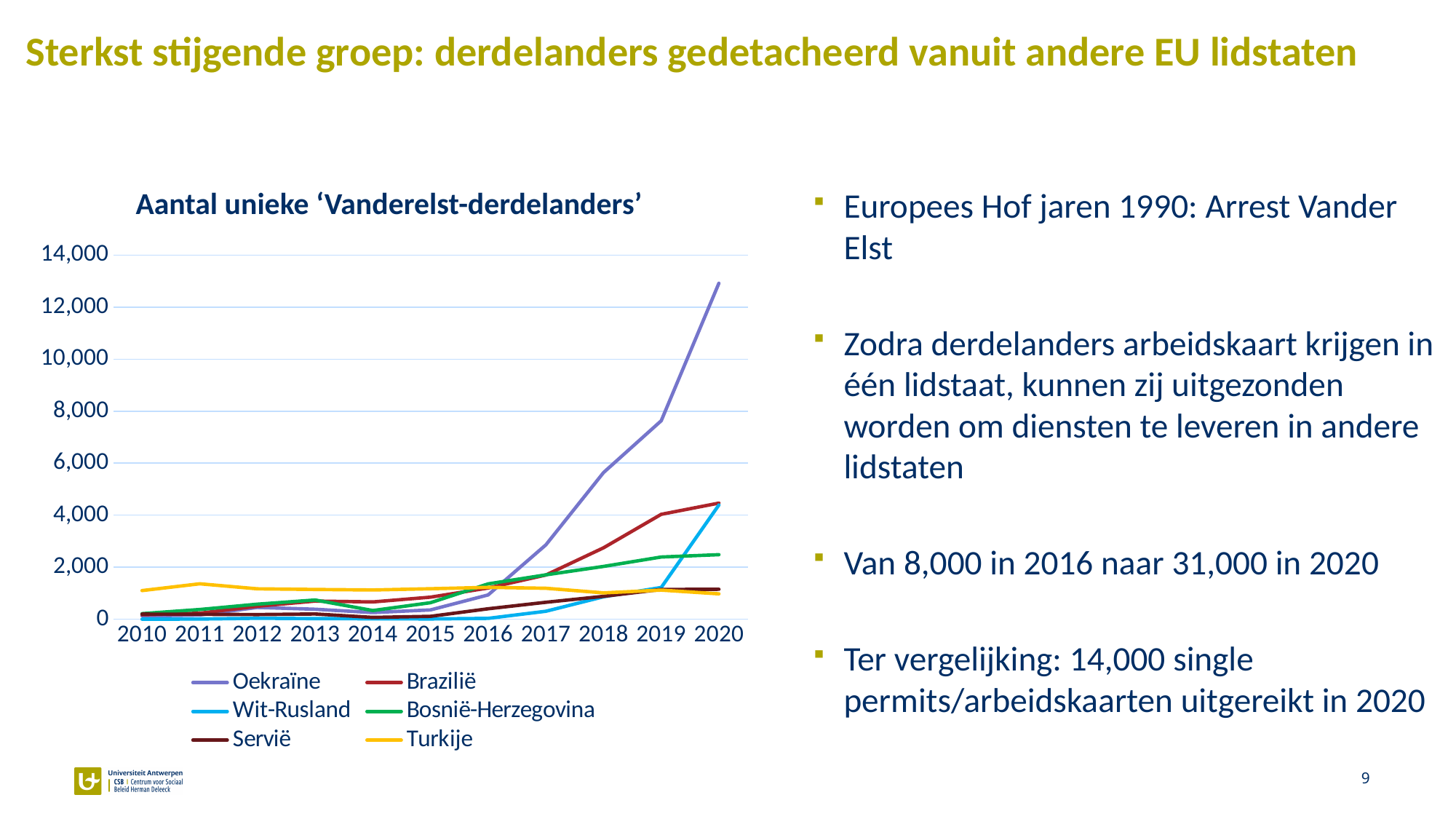
Is the value for Oekraïne in 2019 greater or less than 8,000? less Which is larger in 2011, the value for Turkije or the value for Oekraïne? Turkije What is the title of the chart? Aantal unieke ‘Vanderelst-derdelanders’ Is the value for Bosnië-Herzegovina in 2020 greater or less than 2,000? greater How many years are shown on the x axis of the chart? 11 Does the value for Oekraïne rise or fall between 2016 and 2020? rise How many series does the legend of the chart list? 6 Is the value for Brazilië in 2020 greater or less than 4,000? greater Which series has the highest value in 2020? Oekraïne Which is larger in 2020, the value for Oekraïne or the value for Brazilië? Oekraïne What kind of chart is shown on the slide? line chart